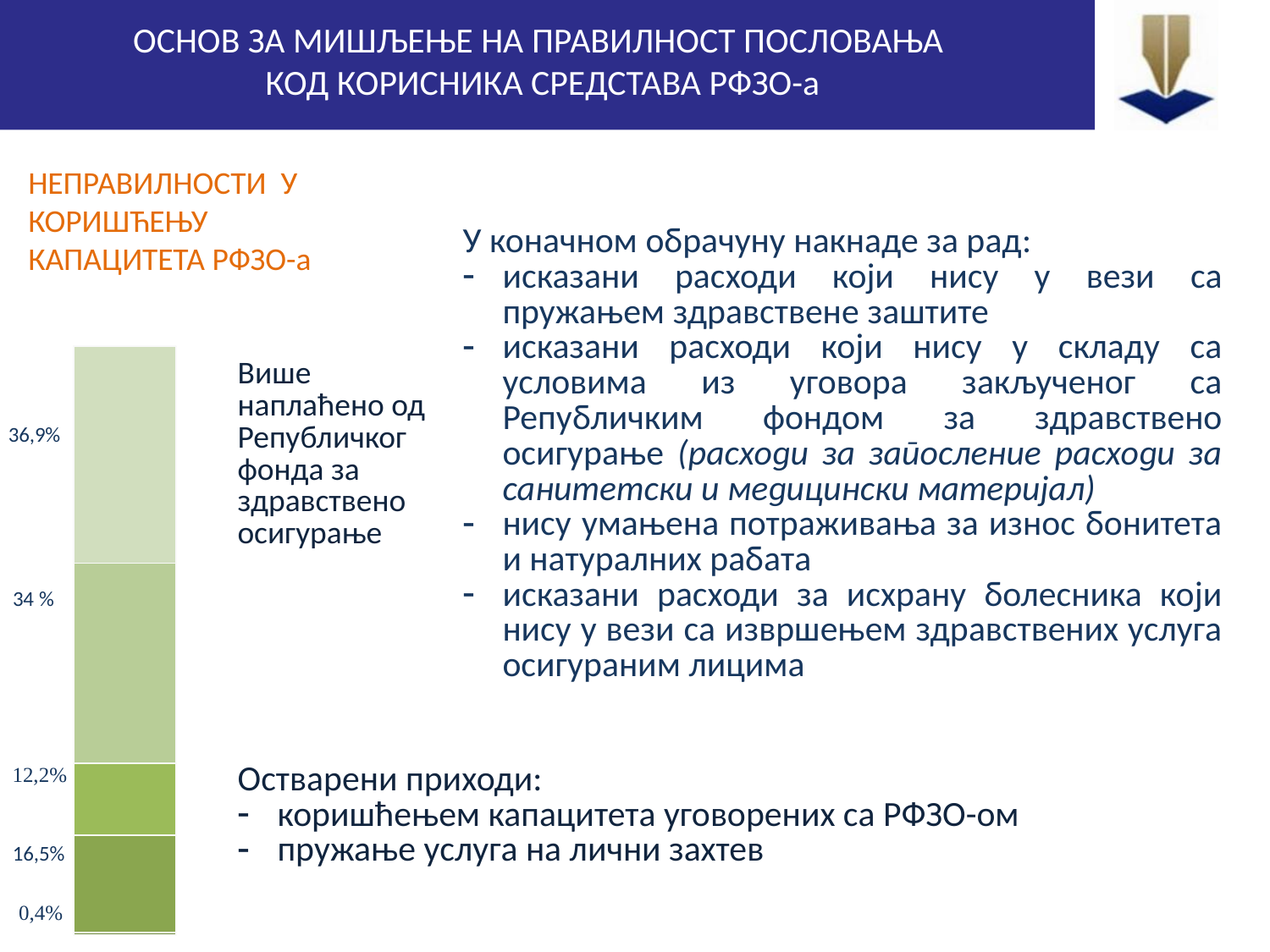
What is the largest value labelled on the stacked bar? 36,9% What colour family are the segments of the stacked bar? Green What is the smallest value labelled on the stacked bar? 0,4% What is the total of all the labelled values on the stacked bar? 100% Which is larger, the segment labelled 12,2% or the segment labelled 16,5%? 16,5% What is the difference between the 36,9% segment and the 34 % segment? 2,9% What is the value labelled for the topmost segment of the stacked bar? 36,9% What is the difference between the 16,5% segment and the 12,2% segment? 4,3% How many segments does the stacked bar on the slide have? 5 What text is written directly to the right of the stacked bar? Више наплаћено од Републичког фонда за здравствено осигурање What kind of chart is shown on the left of the slide? Stacked bar chart What is the value labelled for the bottom segment of the stacked bar? 0,4%